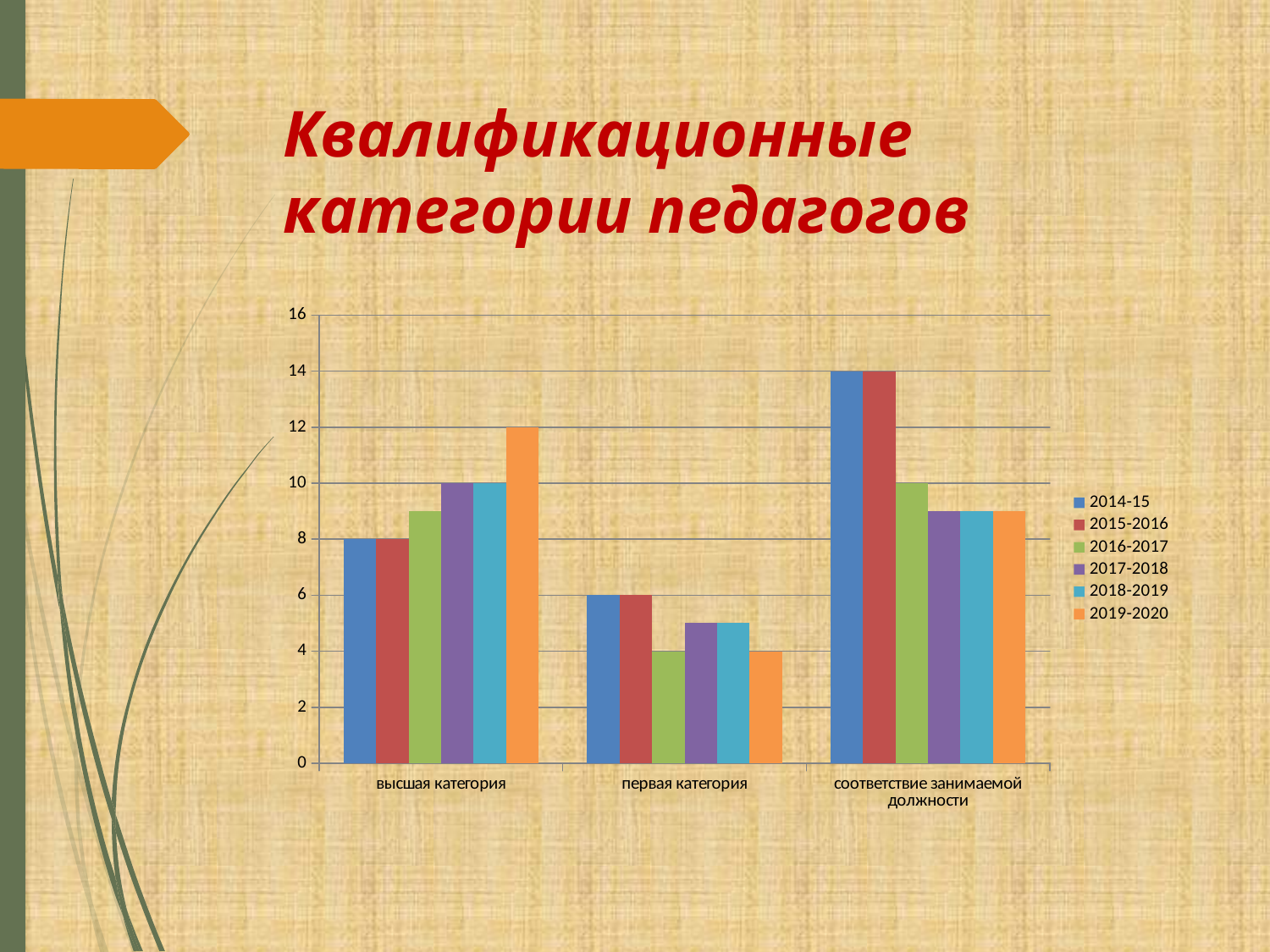
What is the value for 2014-15 in the соответствие занимаемой должности group? 14 How many categories are shown on the x axis? 3 Is the value for 2019-2020 in the соответствие занимаемой должности group greater or less than 10? less Which is larger in the первая категория group: the value for 2014-15 or the value for 2019-2020? 2014-15 What is the value for 2017-2018 in the высшая категория group? 10 Which series has the highest value in the высшая категория group? 2019-2020 How many series does the legend list? 6 What kind of chart is shown on the slide? bar chart What is the value for 2016-2017 in the первая категория group? 4 What is the value for 2019-2020 in the высшая категория group? 12 Is the value for 2016-2017 in the высшая категория group greater or less than 8? greater What is the difference between the 2014-15 value and the 2016-2017 value in the соответствие занимаемой должности group? 4